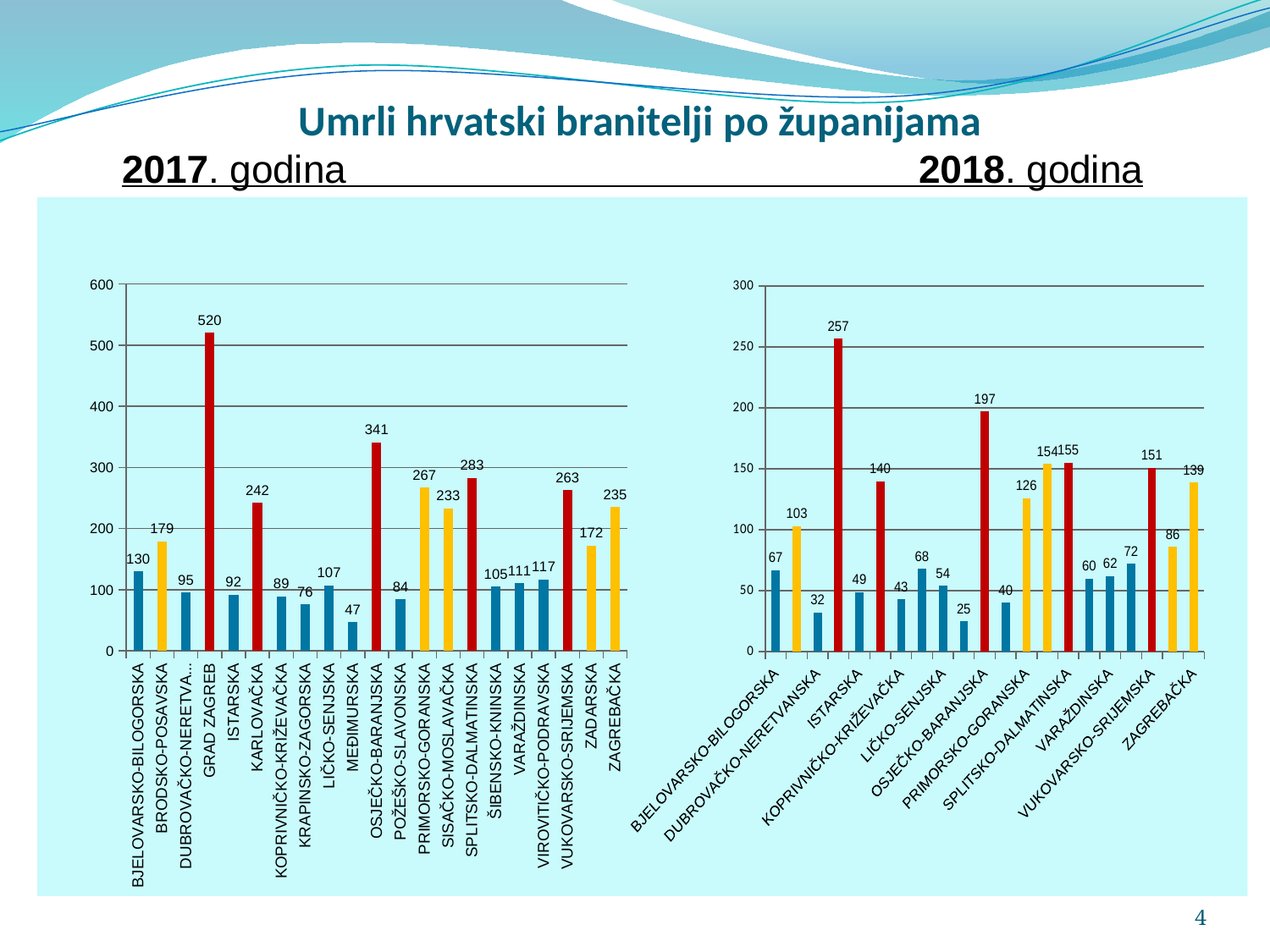
In the 2017 chart, which is larger: PRIMORSKO-GORANSKA or VUKOVARSKO-SRIJEMSKA? PRIMORSKO-GORANSKA How many categories are shown in the 2017 chart? 21 In the 2018 chart, what is the value for OSJEČKO-BARANJSKA? 197 In the 2017 chart, which category has the highest value? GRAD ZAGREB In the 2017 chart, what is the value for ZADARSKA? 172 In the 2017 chart, which category has the lowest value? MEĐIMURSKA What is the title of the slide above the two charts? Umrli hrvatski branitelji po županijama In the 2017 chart, what is the value for GRAD ZAGREB? 520 In the 2018 chart, what is the value for VUKOVARSKO-SRIJEMSKA? 151 In the 2017 chart, what is the difference between the values for OSJEČKO-BARANJSKA and SPLITSKO-DALMATINSKA? 58 What kind of chart is the 2017 chart? bar chart In the 2018 chart, what is the highest value shown? 257